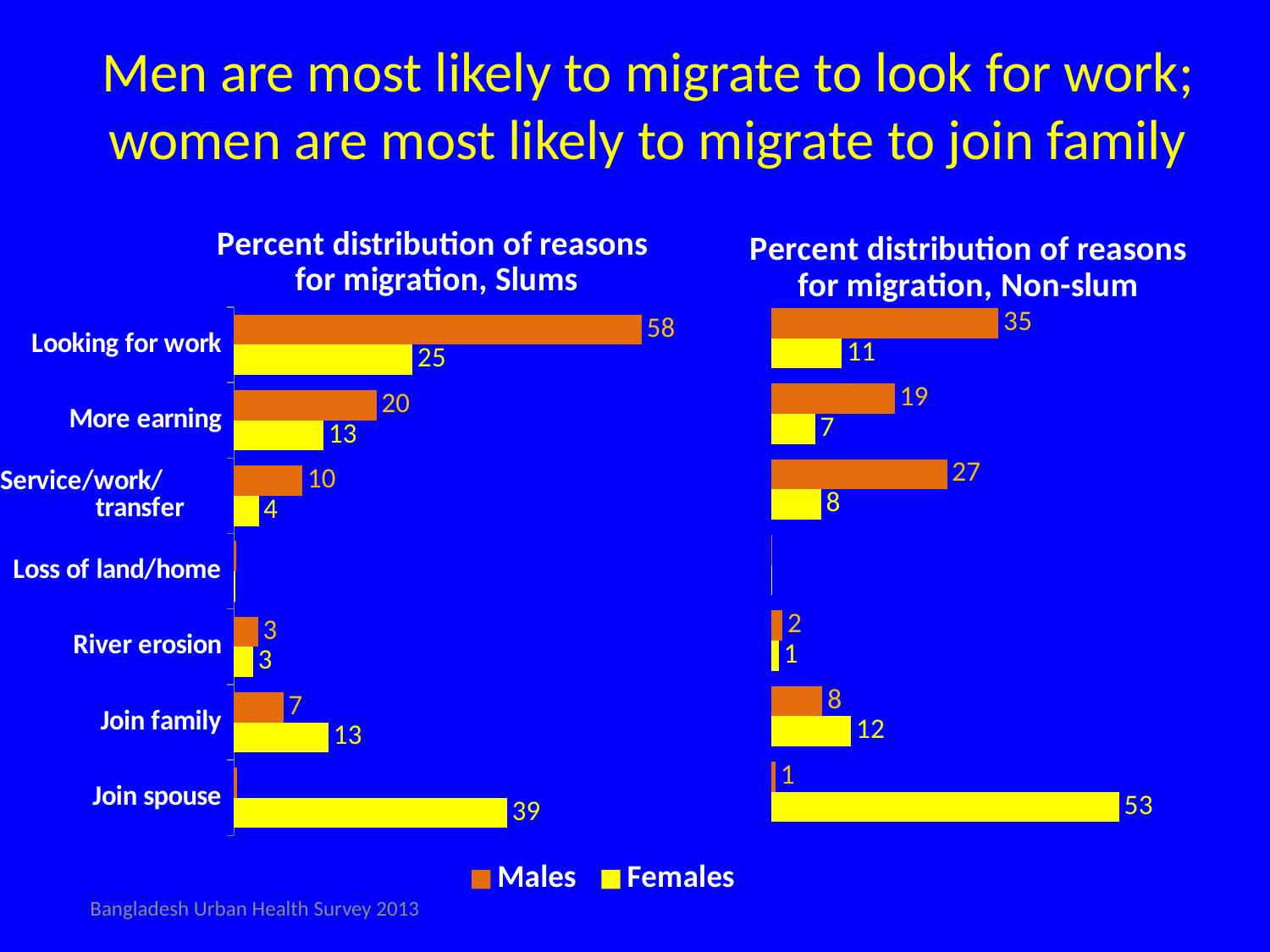
What kind of chart is the 'Percent distribution of reasons for migration, Non-slum' chart? Bar chart In the 'Percent distribution of reasons for migration, Slums' chart, what is the value for Females for Join family? 13 How many reason categories are shown in the 'Percent distribution of reasons for migration, Slums' chart? 7 How many series does the legend list? 2 In the 'Percent distribution of reasons for migration, Slums' chart, which is larger for More earning, the Males value or the Females value? Males In the 'Percent distribution of reasons for migration, Non-slum' chart, what is the difference between the Females and Males values for Join spouse? 52 In the 'Percent distribution of reasons for migration, Non-slum' chart, which reason has the highest value for Males? Looking for work In the 'Percent distribution of reasons for migration, Slums' chart, which reason has the highest value for Females? Join spouse In the 'Percent distribution of reasons for migration, Non-slum' chart, what is the value for Males for Service/work/transfer? 27 In the 'Percent distribution of reasons for migration, Slums' chart, what is the value for Males for Looking for work? 58 In the 'Percent distribution of reasons for migration, Slums' chart, what is the difference between the Males and Females values for Looking for work? 33 In the 'Percent distribution of reasons for migration, Non-slum' chart, what is the value for Females for Join spouse? 53